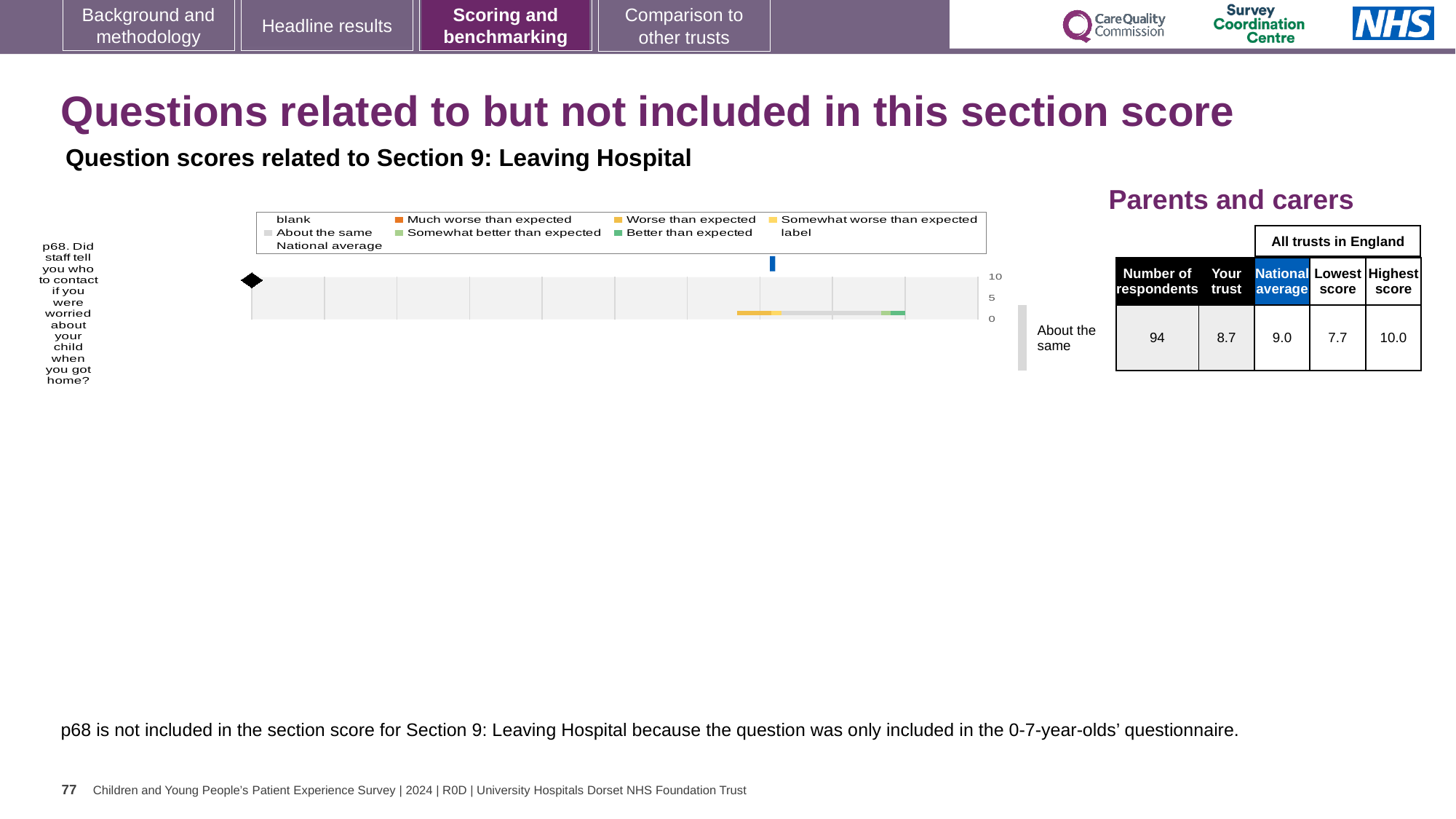
What category label is shown to the right of the p68 bar? About the same In the table, what is the National average score for p68? 9.0 In the table, what is the 'Your trust' score for p68? 8.7 What is the difference between the Highest score and the Lowest score for p68 in the table? 2.3 What type of chart is used to show the p68 question score? bar chart Which is larger for p68: the 'Your trust' score or the National average? National average In the table, what is the Highest score among all trusts in England for p68? 10.0 How many respondents answered p68 according to the table? 94 How many entries does the chart legend list? 9 Which question number is plotted in the chart? p68 Is the National average marker on the p68 chart greater or less than 5? greater In the table, what is the Lowest score among all trusts in England for p68? 7.7